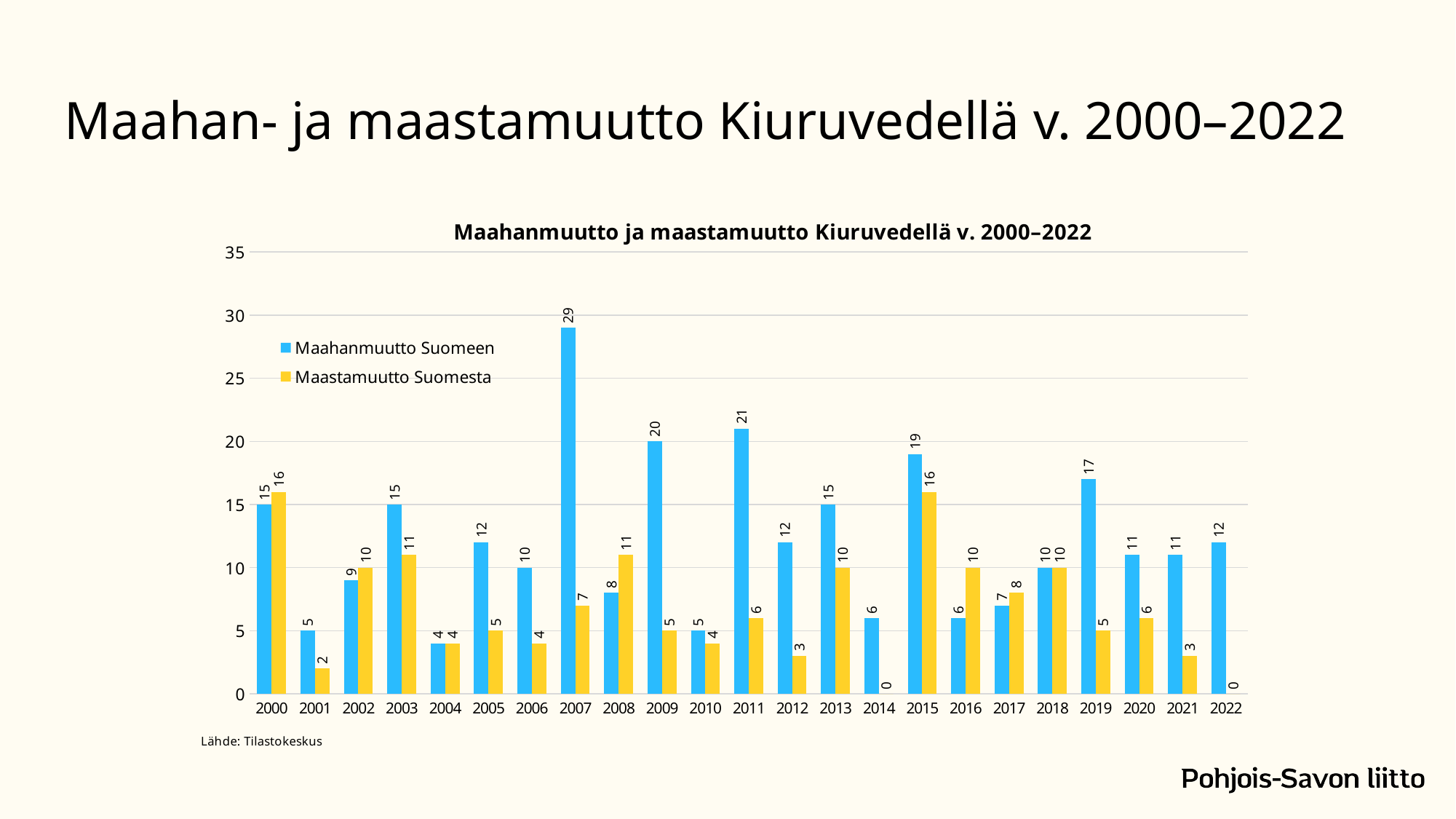
What is the value of Maastamuutto Suomesta in 2015? 16 What is the difference between Maahanmuutto Suomeen and Maastamuutto Suomesta in 2011? 15 In which year is Maahanmuutto Suomeen highest? 2007 Which is larger in 2000, Maahanmuutto Suomeen or Maastamuutto Suomesta? Maastamuutto Suomesta How many years are shown on the x axis? 23 What colour represents Maahanmuutto Suomeen? blue Is the value of Maahanmuutto Suomeen in 2009 greater or less than 15? greater What kind of chart is shown? bar chart In which year is Maastamuutto Suomesta lowest? 2014 and 2022 What is the value of Maastamuutto Suomesta in 2022? 0 How many series does the legend list? 2 What is the value of Maahanmuutto Suomeen in 2007? 29